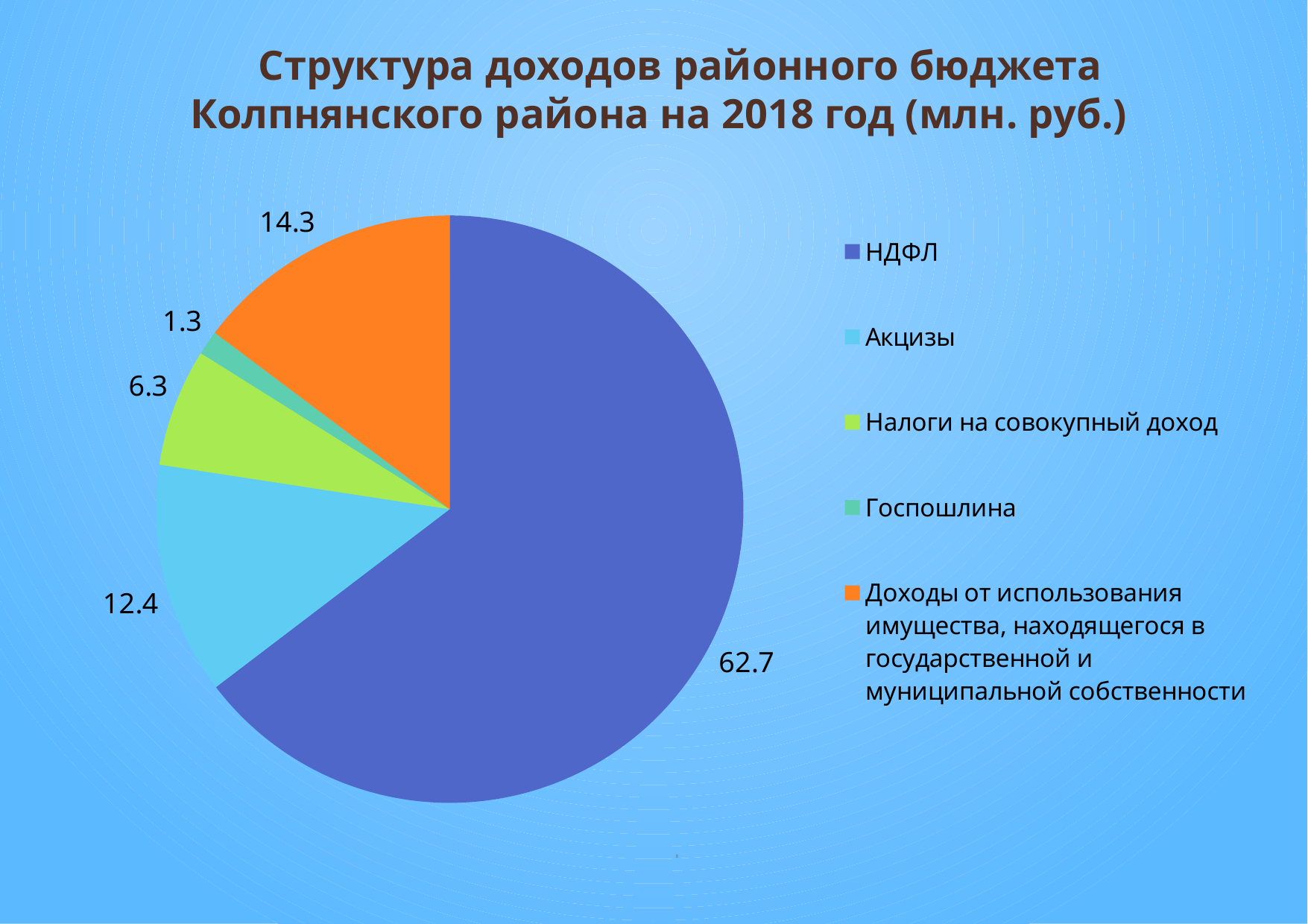
What type of chart is shown on the slide? pie chart How many categories does the pie chart show? 5 What is the difference between the values for НДФЛ and Акцизы? 50.3 Which is larger: Акцизы or Налоги на совокупный доход? Акцизы Which category has the largest slice of the pie? НДФЛ Which category has the smallest slice of the pie? Госпошлина What is the value for Госпошлина? 1.3 What is the value for НДФЛ? 62.7 What is the total of all the values shown in the pie chart? 97.0 What is the value for Доходы от использования имущества, находящегося в государственной и муниципальной собственности? 14.3 What is the value for Налоги на совокупный доход? 6.3 What is the value for Акцизы? 12.4